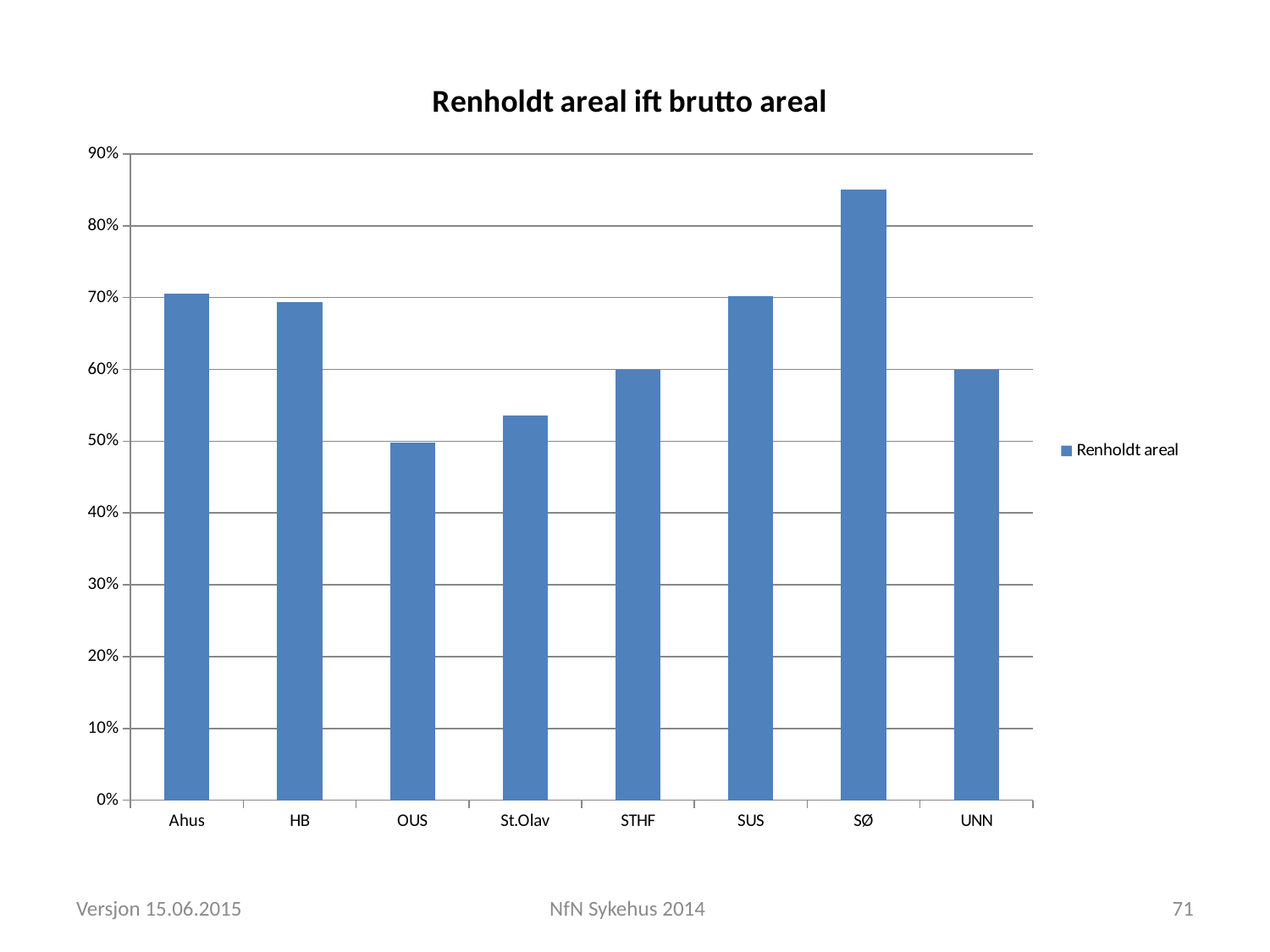
What is the title of the chart? Renholdt areal ift brutto areal What is the name of the series shown in the legend? Renholdt areal How many series does the legend list? 1 Which category has the highest value? SØ Which is larger, the value for SØ or the value for Ahus? SØ Is the value for OUS greater or less than 60%? less How many categories are shown on the x axis of the chart? 8 Is the value for SØ greater or less than 80%? greater What kind of chart is shown on the slide? bar chart Is the value for HB greater or less than 60%? greater Which is larger, the value for OUS or the value for STHF? STHF Which category has the lowest value? OUS